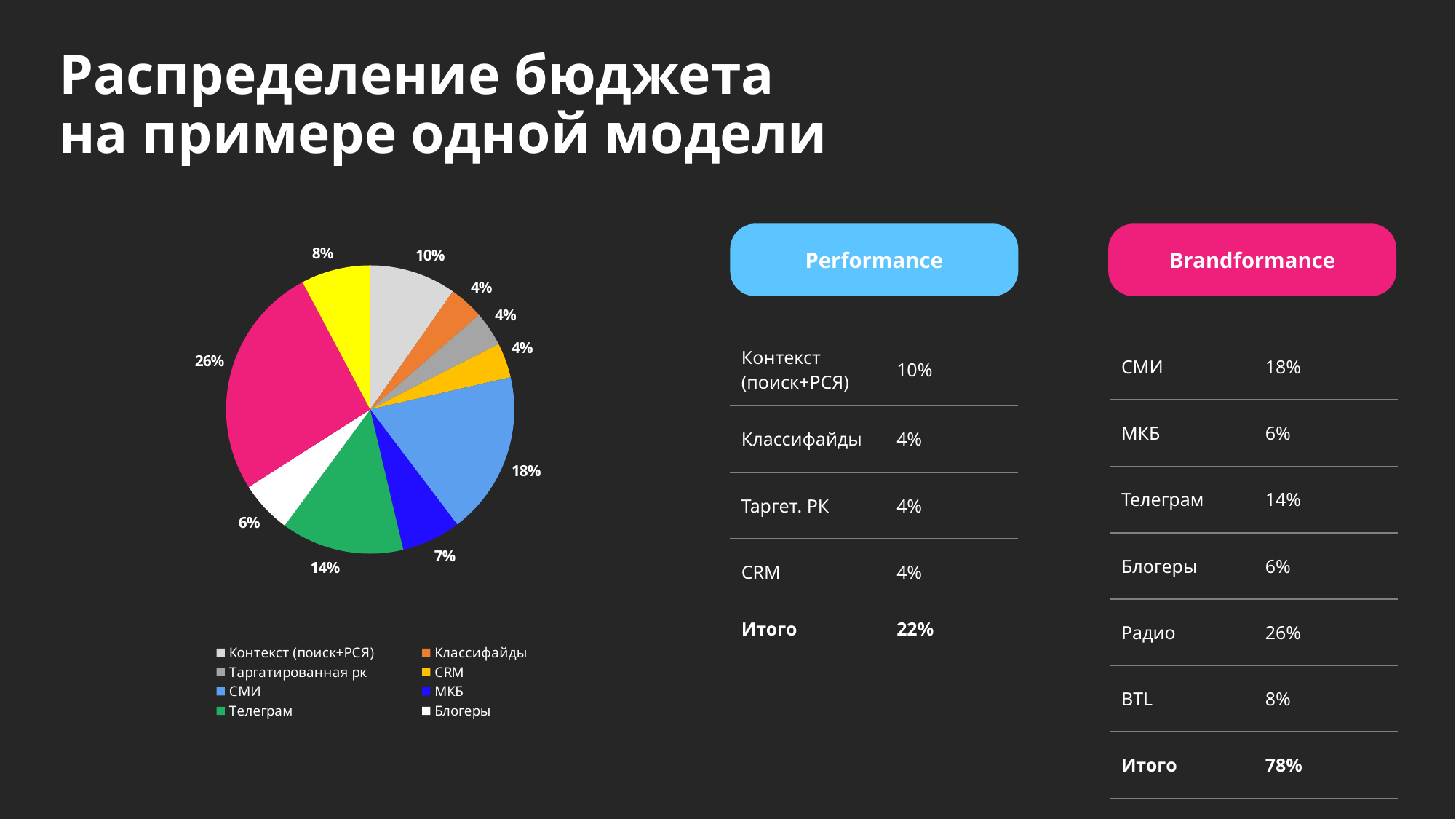
How many entries does the pie chart legend list? 8 How many slices does the pie chart have? 10 What percentage does the Блогеры slice show in the pie chart? 6% What type of chart is shown on the slide? Pie chart What percentage does the Телеграм slice show in the pie chart? 14% What colour is the СМИ slice in the pie chart? Blue What is the smallest percentage labelled on the pie chart? 4% By how many percentage points is the СМИ slice larger than the Телеграм slice? 4 percentage points What percentage of the budget does СМИ receive in the pie chart? 18% Which slice is larger in the pie chart: Контекст (поиск+РСЯ) or Блогеры? Контекст (поиск+РСЯ) What is the largest percentage labelled on the pie chart? 26% What percentage does the Контекст (поиск+РСЯ) slice show in the pie chart? 10%